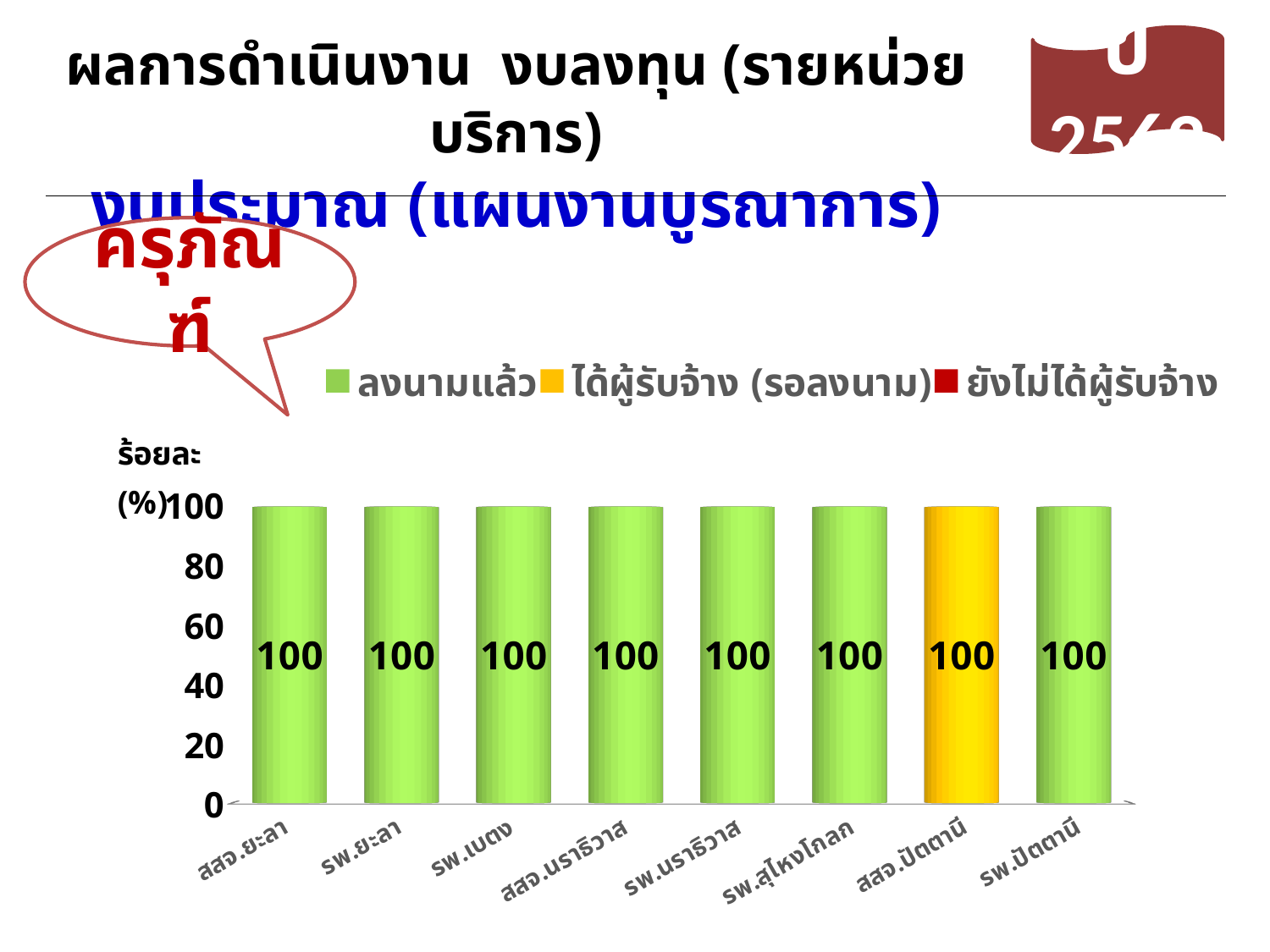
Is the value for รพ.นราธิวาส greater or less than 80? greater Which category's bar is coloured yellow (ได้ผู้รับจ้าง (รอลงนาม)) rather than green? สสจ.ปัตตานี What is the value for รพ.เบตง? 100 How many categories are shown on the x axis of the chart? 8 Do the values rise, fall, or stay flat across the categories from left to right? stay flat What is the value for สสจ.ปัตตานี? 100 What is the value for สสจ.ยะลา? 100 What is the difference between the values for รพ.ยะลา and รพ.ปัตตานี? 0 What is the value for รพ.สุไหงโกลก? 100 What kind of chart is shown on the slide? bar chart How many series does the legend list? 3 What is the label of the y axis? ร้อยละ (%)